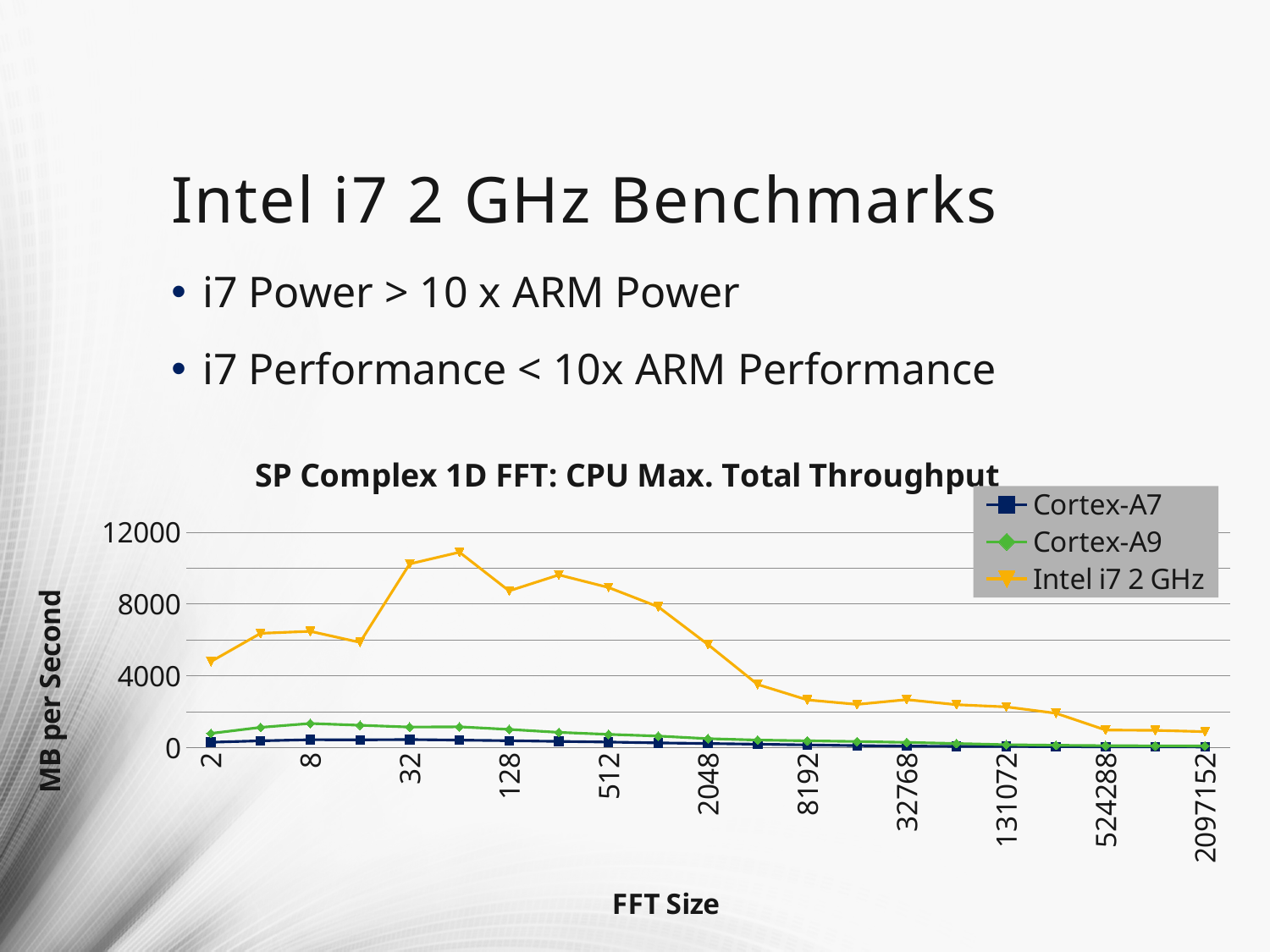
Is the Intel i7 2 GHz value larger at FFT size 32 or at FFT size 2097152? 32 How many series does the chart legend list? 3 Is the value for Intel i7 2 GHz at FFT size 8192 greater or less than 4000? less What kind of chart is shown on the slide? Line chart What is the label of the chart's y axis? MB per Second At FFT size 8, which is larger: Cortex-A9 or Cortex-A7? Cortex-A9 Which series has the lowest throughput across the FFT sizes? Cortex-A7 What is the title of the chart? SP Complex 1D FFT: CPU Max. Total Throughput Does the Intel i7 2 GHz series rise or fall from FFT size 512 to FFT size 2097152? fall Is the value for Intel i7 2 GHz at FFT size 32 greater or less than 8000? greater Which series has the highest throughput at FFT size 32? Intel i7 2 GHz Is the value for Cortex-A9 at FFT size 8 greater or less than 4000? less